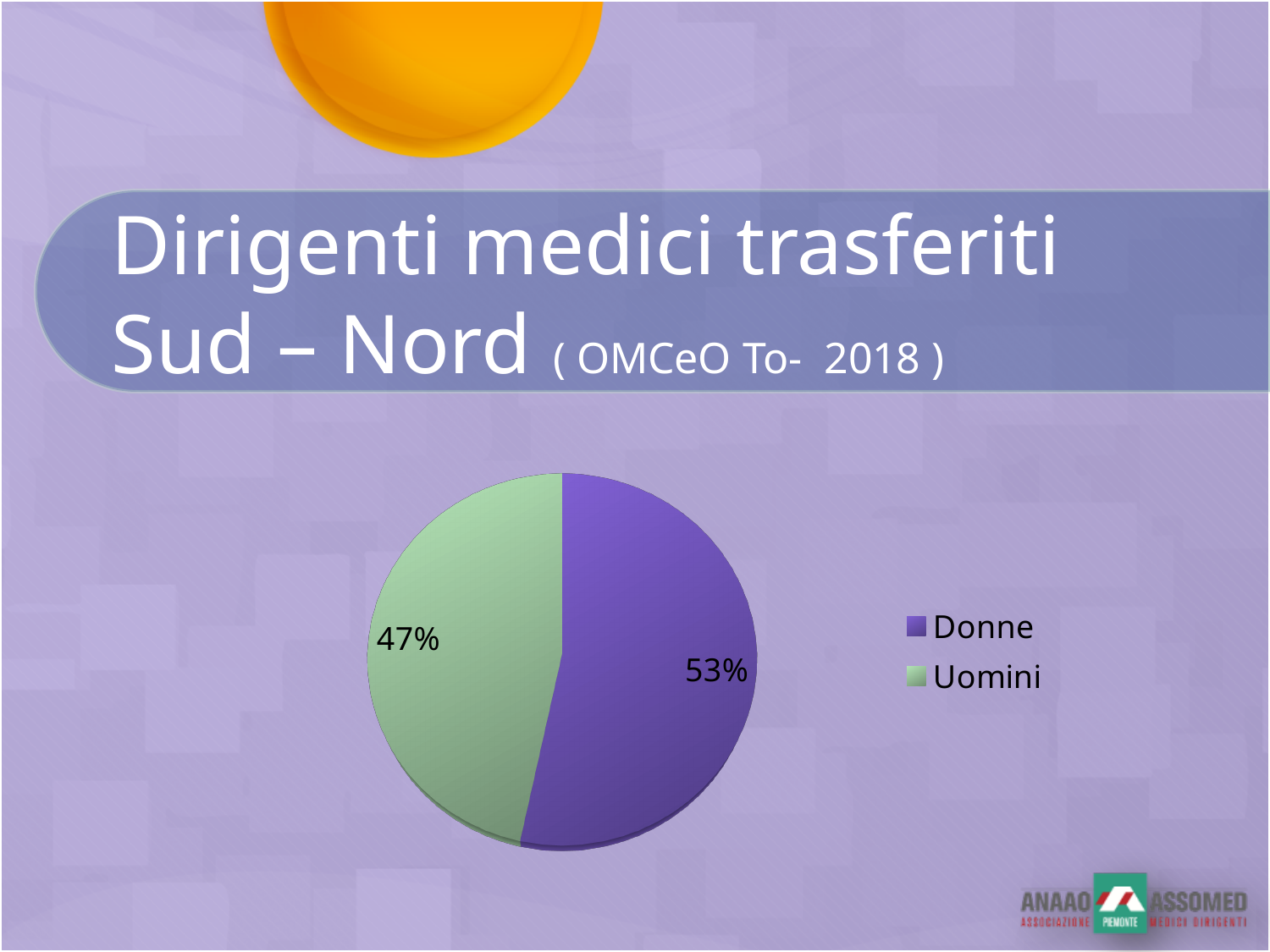
How many entries does the legend list? 2 What colour is the Donne slice? purple How many slices does the pie chart have? 2 Which category has the smallest slice of the pie? Uomini What kind of chart is shown on the slide? pie chart What colour is the Uomini slice? green Which category has the largest slice of the pie? Donne What share of the pie does Uomini represent? 47% What share of the pie does Donne represent? 53% What is the difference in percentage points between the Donne and Uomini slices? 6% Which is larger, the Donne slice or the Uomini slice? Donne